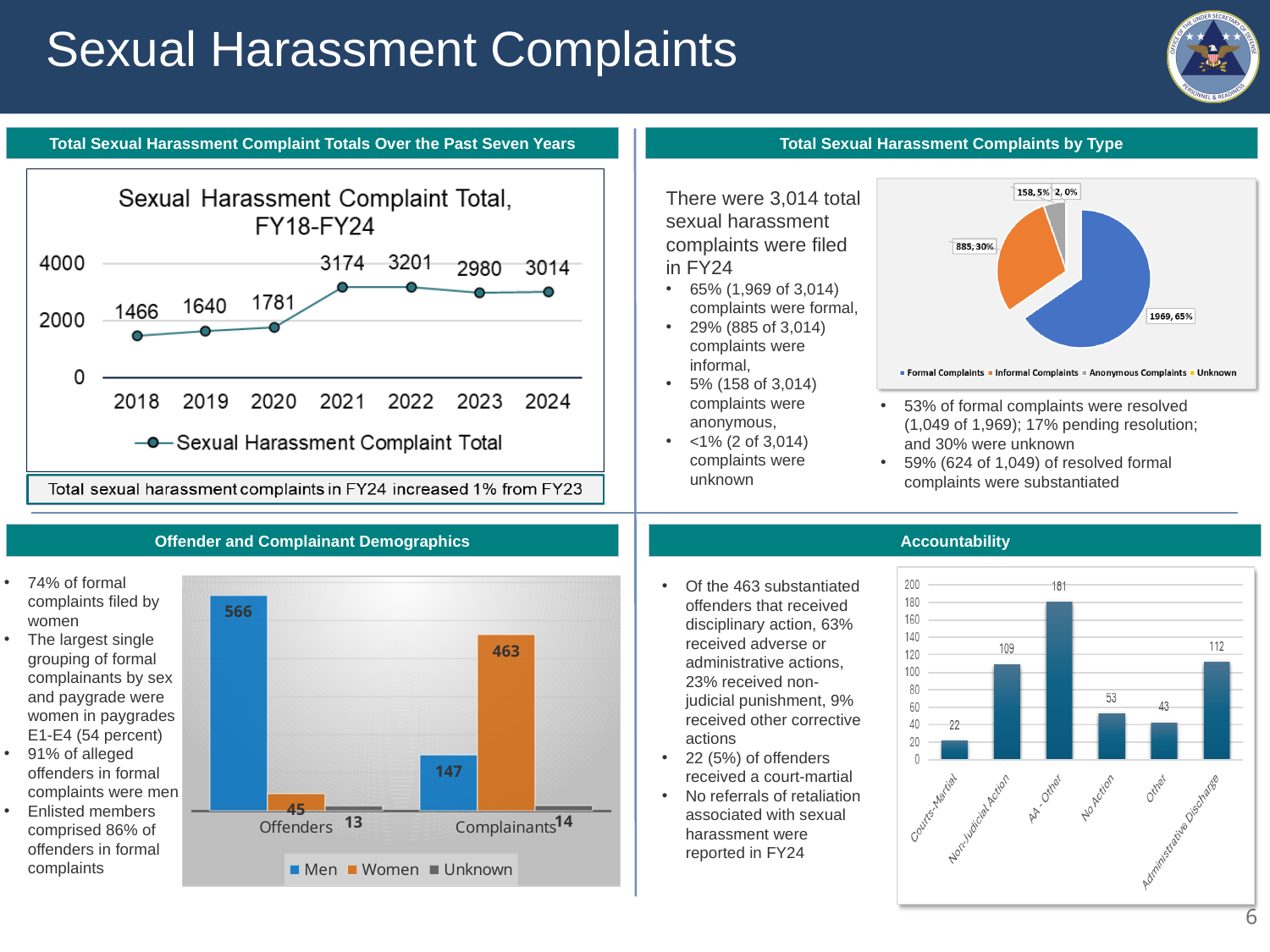
In the 'Sexual Harassment Complaint Total, FY18-FY24' line chart, how many years are plotted? 7 In the 'Sexual Harassment Complaint Total, FY18-FY24' line chart, what is the difference between the 2024 and 2023 values? 34 In the 'Accountability' chart, what is the value for Courts-Martial? 22 In the 'Accountability' chart, which category has the highest value? AA - Other In the 'Sexual Harassment Complaint Total, FY18-FY24' line chart, what was the total for 2021? 3174 In the 'Total Sexual Harassment Complaints by Type' pie chart, what share of complaints were Informal Complaints? 30% What kind of chart is shown in the 'Accountability' section? Bar chart In the 'Offender and Complainant Demographics' bar chart, what is the difference between Men and Women among Offenders? 521 In the 'Total Sexual Harassment Complaints by Type' pie chart, how many Anonymous Complaints are shown? 158 In the 'Sexual Harassment Complaint Total, FY18-FY24' line chart, which year has the highest value? 2022 In the 'Offender and Complainant Demographics' bar chart, what is the value for Women among Complainants? 463 In the 'Total Sexual Harassment Complaints by Type' pie chart, how many categories does the legend list? 4